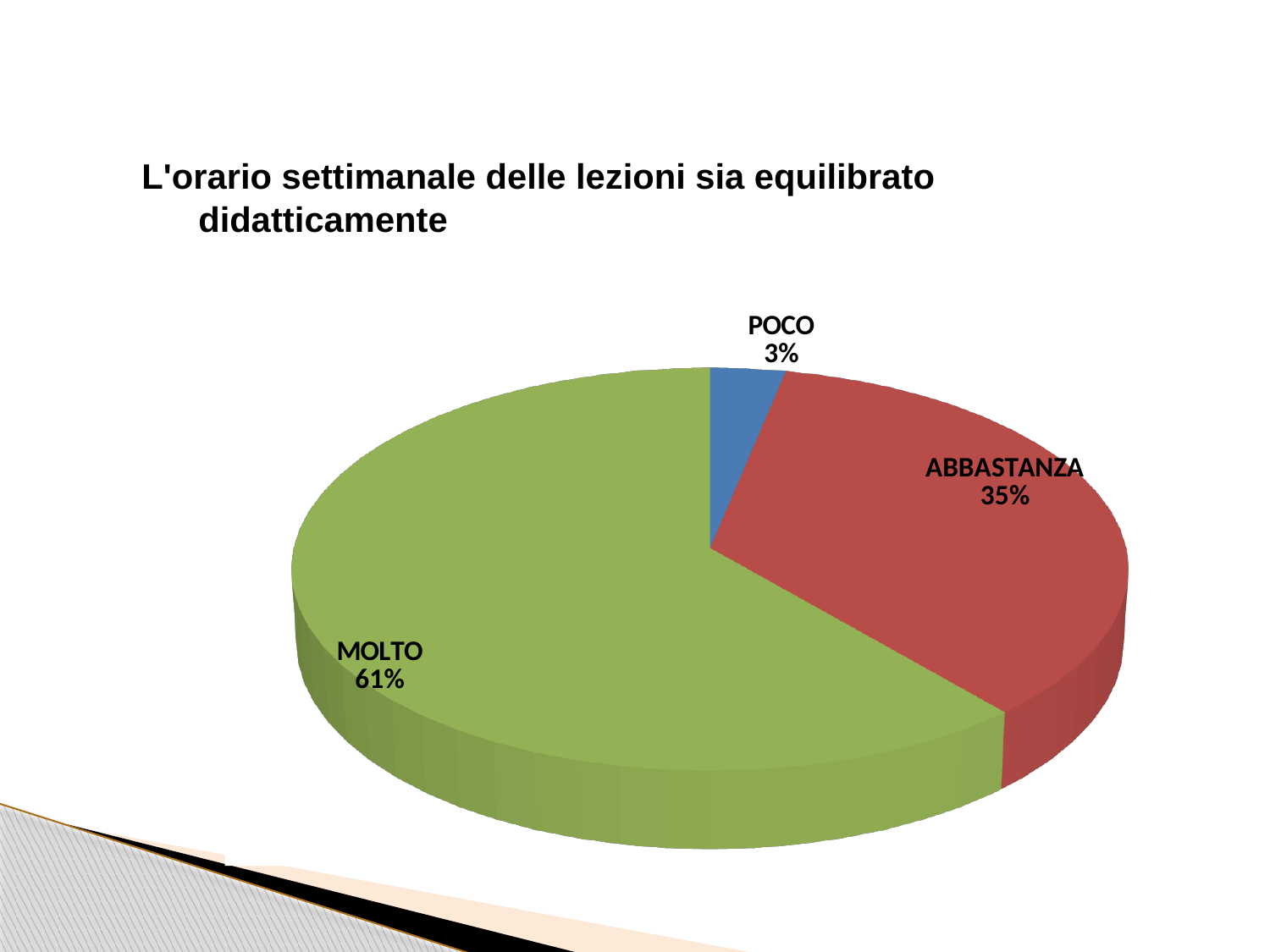
What is the difference in percentage points between the MOLTO and ABBASTANZA slices? 26 What colour is the MOLTO slice? Green Which slice is larger, ABBASTANZA or POCO? ABBASTANZA How many slices does the pie chart have? 3 Which slice of the pie is the smallest? POCO What is the difference in percentage points between the ABBASTANZA and POCO slices? 32 What percentage of the pie is labelled ABBASTANZA? 35% What kind of chart is shown on the slide? Pie chart What percentage of the pie is labelled MOLTO? 61% What is the title of the chart? L'orario settimanale delle lezioni sia equilibrato didatticamente What percentage of the pie is labelled POCO? 3% Which slice of the pie is the largest? MOLTO